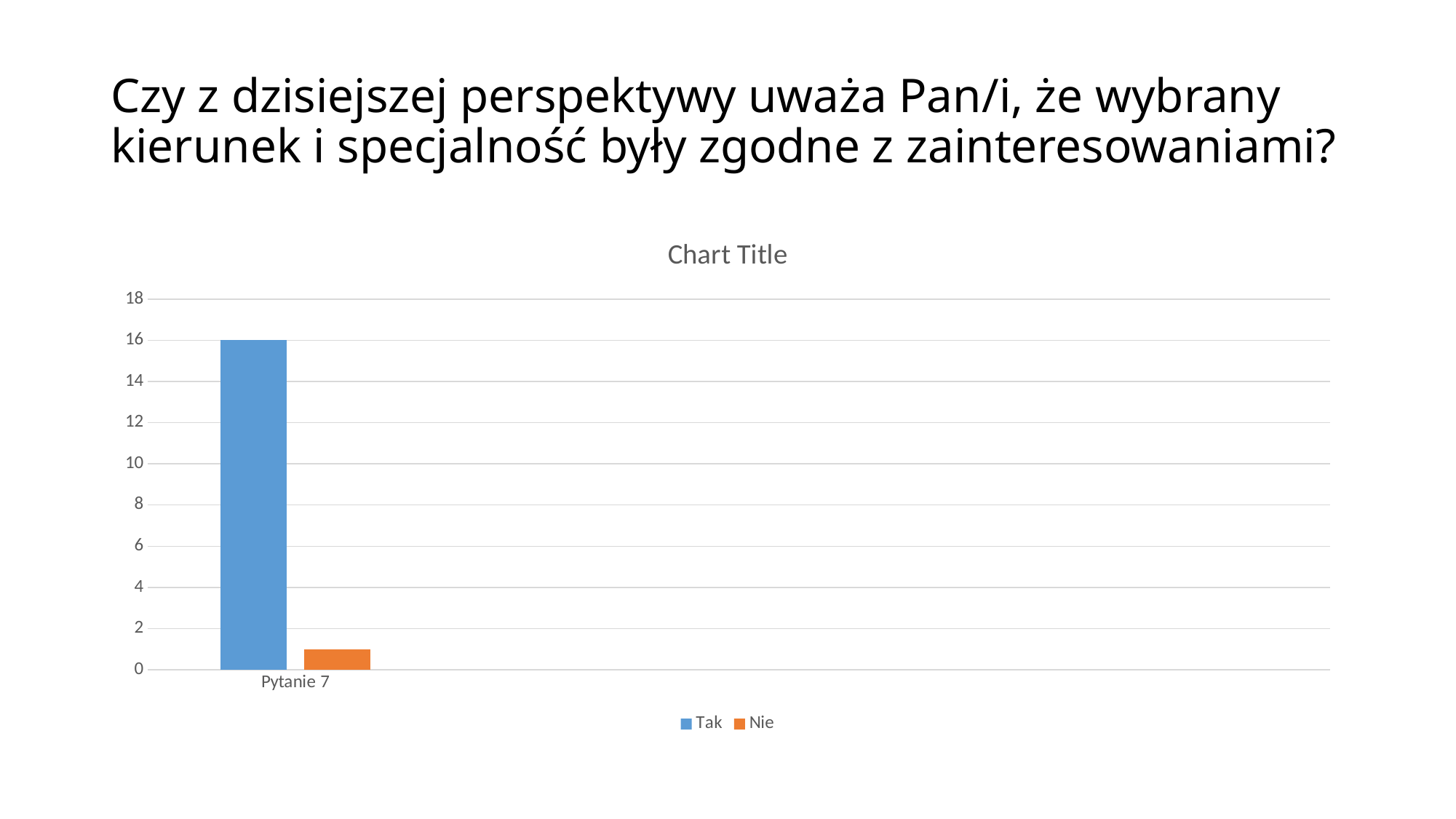
What is the highest value shown on the vertical axis? 18 What colour is the bar for the Tak series? blue Which series has the lowest value in the chart? Nie What kind of chart is shown on the slide? bar chart How many categories are shown on the x axis? 1 How many series does the legend list? 2 Which series has the higher value for Pytanie 7, Tak or Nie? Tak What is the label of the category on the x axis? Pytanie 7 Which series has the highest value in the chart? Tak Is the value of the Tak series for Pytanie 7 greater or less than 10? greater Is the value of the Nie series for Pytanie 7 greater or less than 2? less What is the value of the Tak series for Pytanie 7? 16